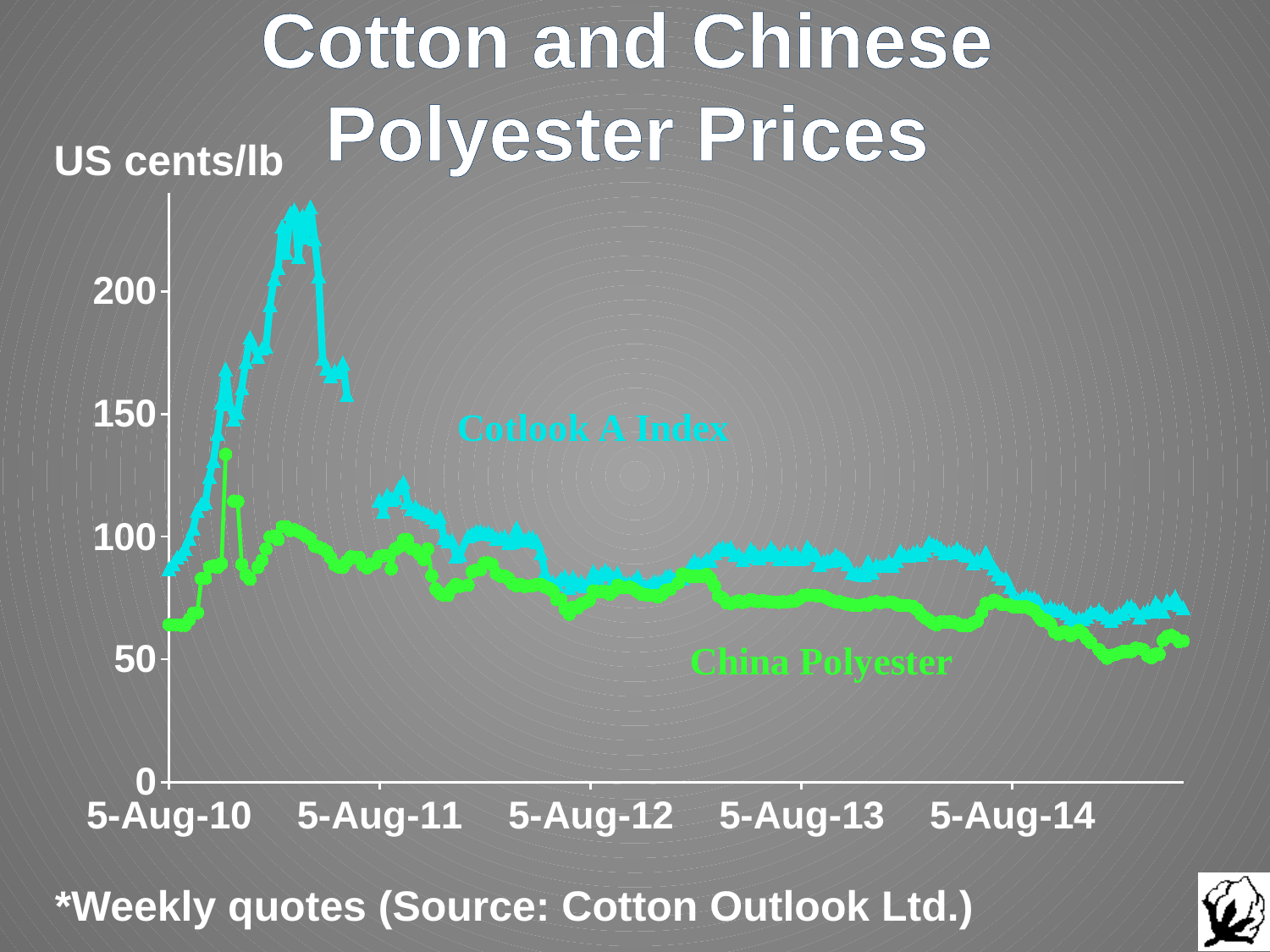
Which series reaches the higher peak value, Cotlook A Index or China Polyester? Cotlook A Index Is the peak value of the Cotlook A Index greater or less than 200? greater What unit is shown for the vertical axis of the chart? US cents/lb What kind of chart is shown on the slide? Line chart Is the peak value of China Polyester greater or less than 100? greater What are the names of the two series plotted on the chart? Cotlook A Index and China Polyester Is the Cotlook A Index value at 5-Aug-12 greater or less than 100? less How many series are plotted on the chart? 2 At 5-Aug-11, which series has the higher value, Cotlook A Index or China Polyester? Cotlook A Index Between 5-Aug-11 and 5-Aug-12, does the Cotlook A Index rise or fall? fall